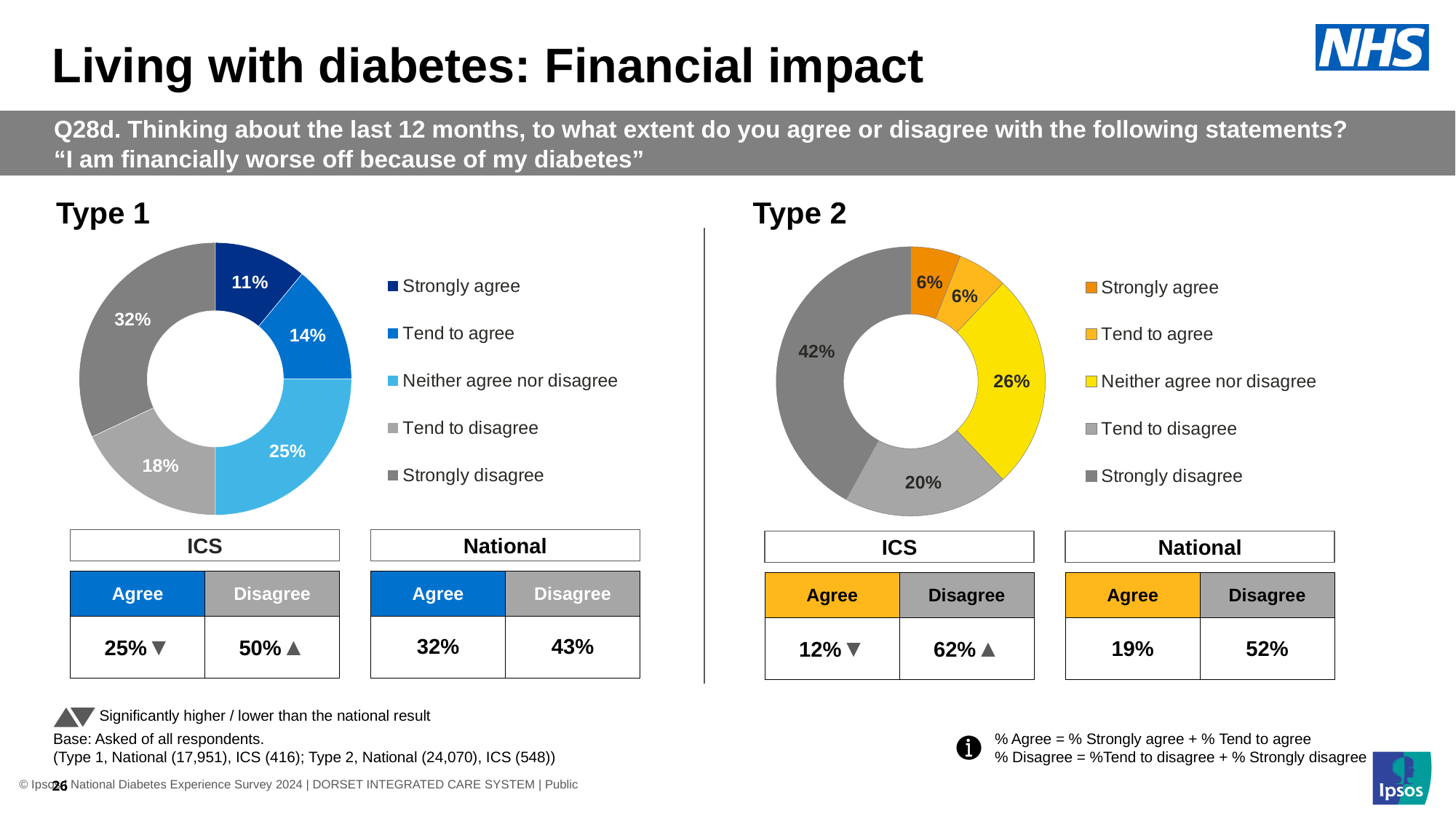
In the Type 1 chart, what percentage of respondents strongly agree? 11% In the Type 1 chart, which response category has the smallest share? Strongly agree In the Type 2 chart, which response category has the largest share? Strongly disagree In the Type 2 chart, what percentage of respondents strongly disagree? 42% What kind of chart is used to show the Type 1 results? Doughnut (pie) chart In the Type 1 chart, what is the difference between the Neither agree nor disagree share and the Tend to agree share? 11 percentage points In the Type 2 chart, what is the difference between the Strongly disagree share and the Tend to disagree share? 22 percentage points In the Type 1 chart, which response category has the largest share? Strongly disagree In the Type 1 chart, which is larger: the Tend to disagree share or the Neither agree nor disagree share? Neither agree nor disagree How many response categories does the legend of the Type 2 chart list? 5 In the Type 2 chart, what percentage of respondents neither agree nor disagree? 26% In the Type 1 chart, what percentage of respondents tend to disagree? 18%